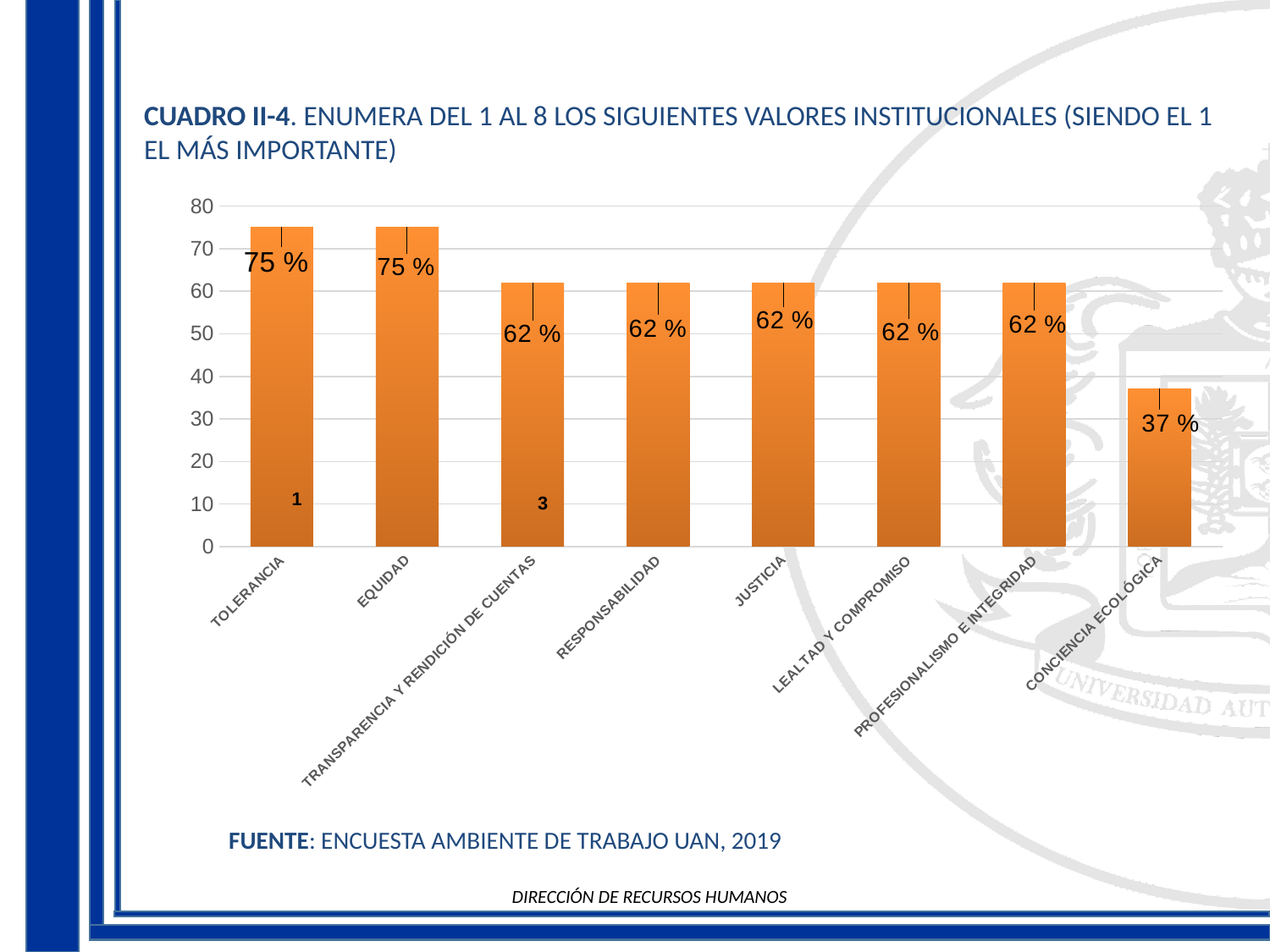
What kind of chart is shown on the slide? bar chart What is the difference between the values for TOLERANCIA and CONCIENCIA ECOLÓGICA? 38 % What is the value for TOLERANCIA? 75 % What is the value for EQUIDAD? 75 % What is the difference between the values for EQUIDAD and RESPONSABILIDAD? 13 % What is the value for JUSTICIA? 62 % Which is larger, the value for LEALTAD Y COMPROMISO or the value for CONCIENCIA ECOLÓGICA? LEALTAD Y COMPROMISO Is the value for CONCIENCIA ECOLÓGICA greater or less than 40? less Which category has the lowest value? CONCIENCIA ECOLÓGICA What is the value for CONCIENCIA ECOLÓGICA? 37 % How many categories are shown on the x axis? 8 What source is cited for the chart's data? ENCUESTA AMBIENTE DE TRABAJO UAN, 2019